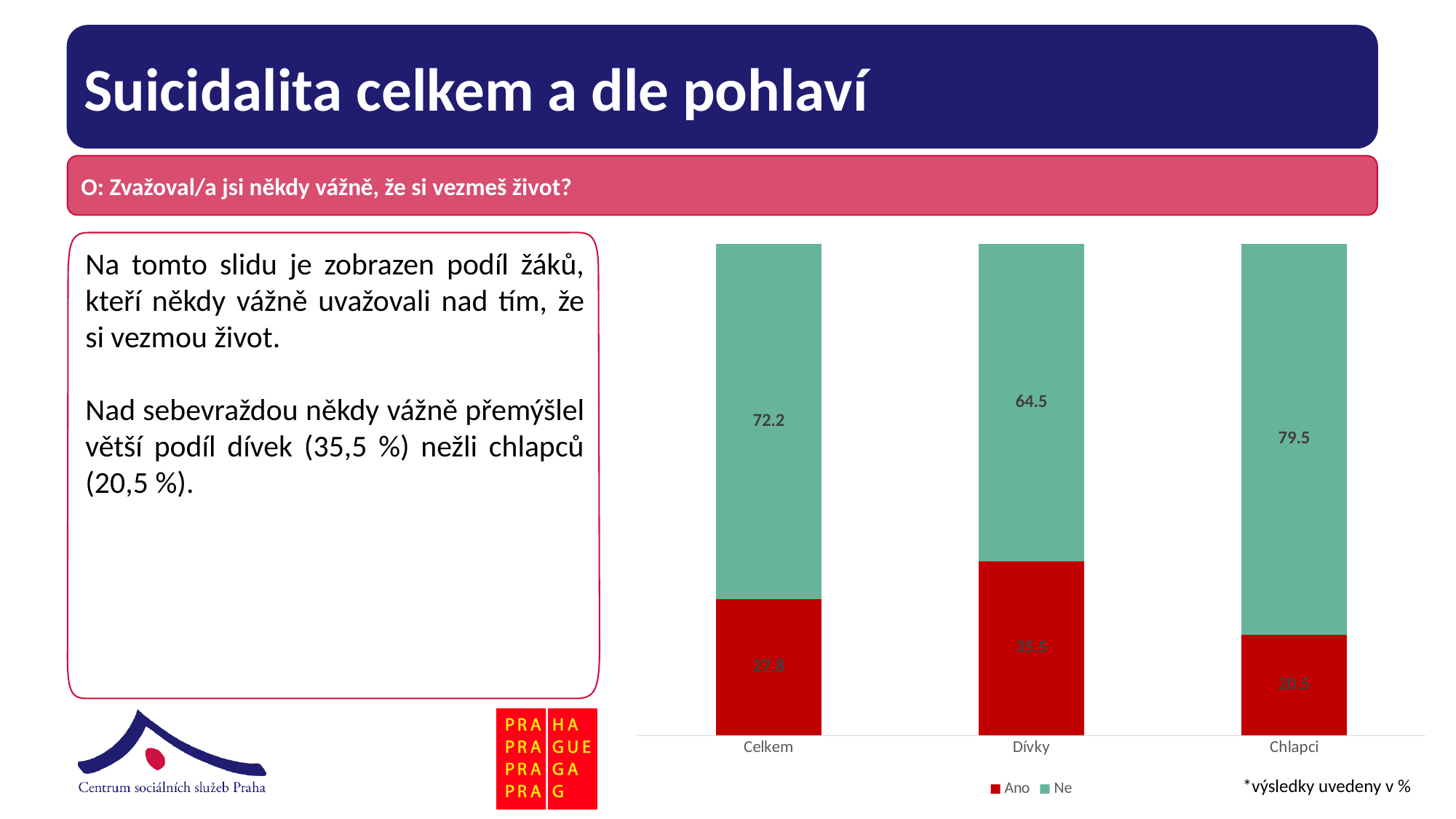
What is the value of "Ne" for Dívky? 64.5 Which category has the lowest "Ne" value? Dívky What is the value of "Ne" for Chlapci? 79.5 What is the difference between the "Ano" values for Dívky and Chlapci? 15 How many series does the legend list? 2 What is the total of the stacked bar for Celkem? 100 How many categories are shown on the x axis? 3 Which category has the highest "Ano" value? Dívky What kind of chart is shown on the slide? Stacked bar chart What is the value of "Ano" for Dívky? 35.5 Which is larger: the "Ne" value for Celkem or for Chlapci? Chlapci What is the value of "Ano" for Celkem? 27.8